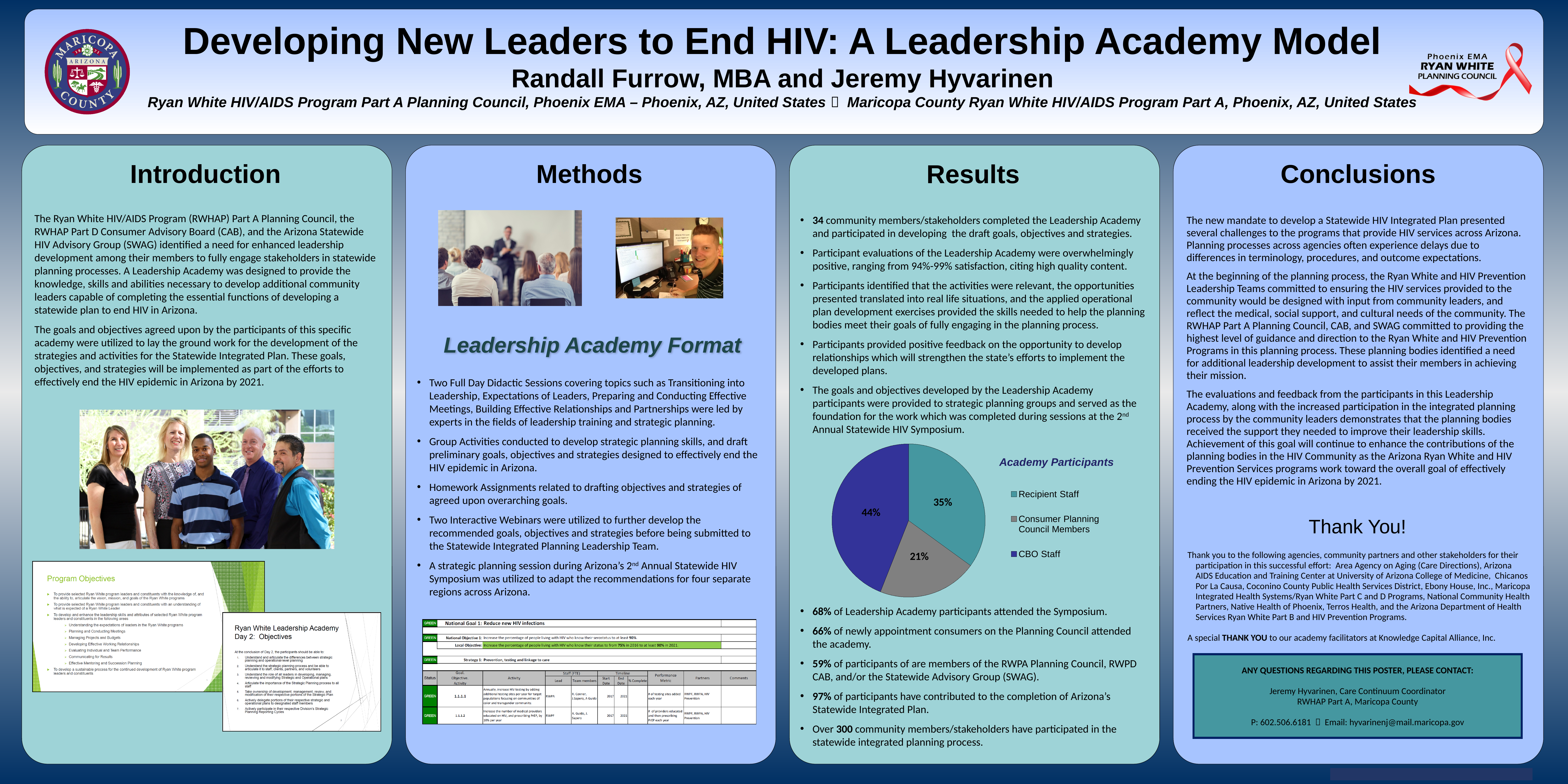
In the "Academy Participants" pie chart, what share of participants are CBO Staff? 44% Which category has the largest slice in the "Academy Participants" pie chart? CBO Staff In the "Academy Participants" pie chart, what colour is the CBO Staff slice? blue In the "Academy Participants" pie chart, how many percentage points larger is the Recipient Staff slice than the Consumer Planning Council Members slice? 14 In the "Academy Participants" pie chart, what share of participants are Recipient Staff? 35% In the "Academy Participants" pie chart, which is larger: the Recipient Staff slice or the CBO Staff slice? CBO Staff Which category has the smallest slice in the "Academy Participants" pie chart? Consumer Planning Council Members How many categories does the "Academy Participants" pie chart show? 3 What kind of chart is the "Academy Participants" chart? pie chart What is the title of the pie chart in the Results section? Academy Participants In the "Academy Participants" pie chart, how many percentage points larger is the CBO Staff slice than the Recipient Staff slice? 9 In the "Academy Participants" pie chart, what share of participants are Consumer Planning Council Members? 21%